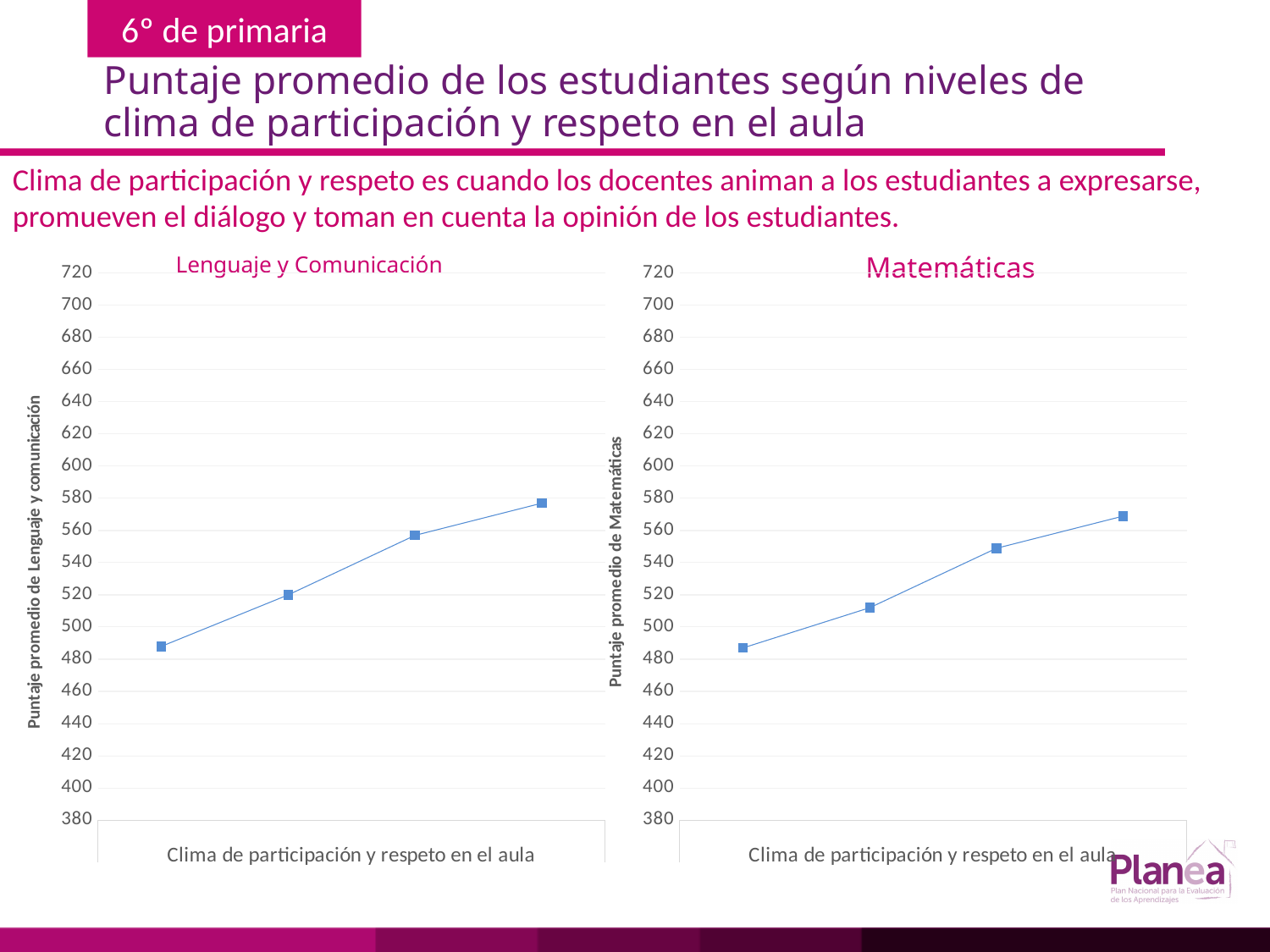
How many data points are plotted in the Lenguaje y Comunicación chart? 4 In the Matemáticas chart, is the value of the second point from the left greater or less than 500? greater What kind of chart is the Matemáticas chart? line chart In the Lenguaje y Comunicación chart, do the values rise or fall from left to right along the x axis? rise In the Lenguaje y Comunicación chart, is the value of the last (rightmost) point greater or less than 560? greater In the Matemáticas chart, do the values rise or fall from left to right along the x axis? rise What is the title of the chart on the right side of the slide? Matemáticas In the Lenguaje y Comunicación chart, is the value of the first (leftmost) point greater or less than 500? less What kind of chart is the Lenguaje y Comunicación chart? line chart What is the x-axis label of the Lenguaje y Comunicación chart? Clima de participación y respeto en el aula How many data points are plotted in the Matemáticas chart? 4